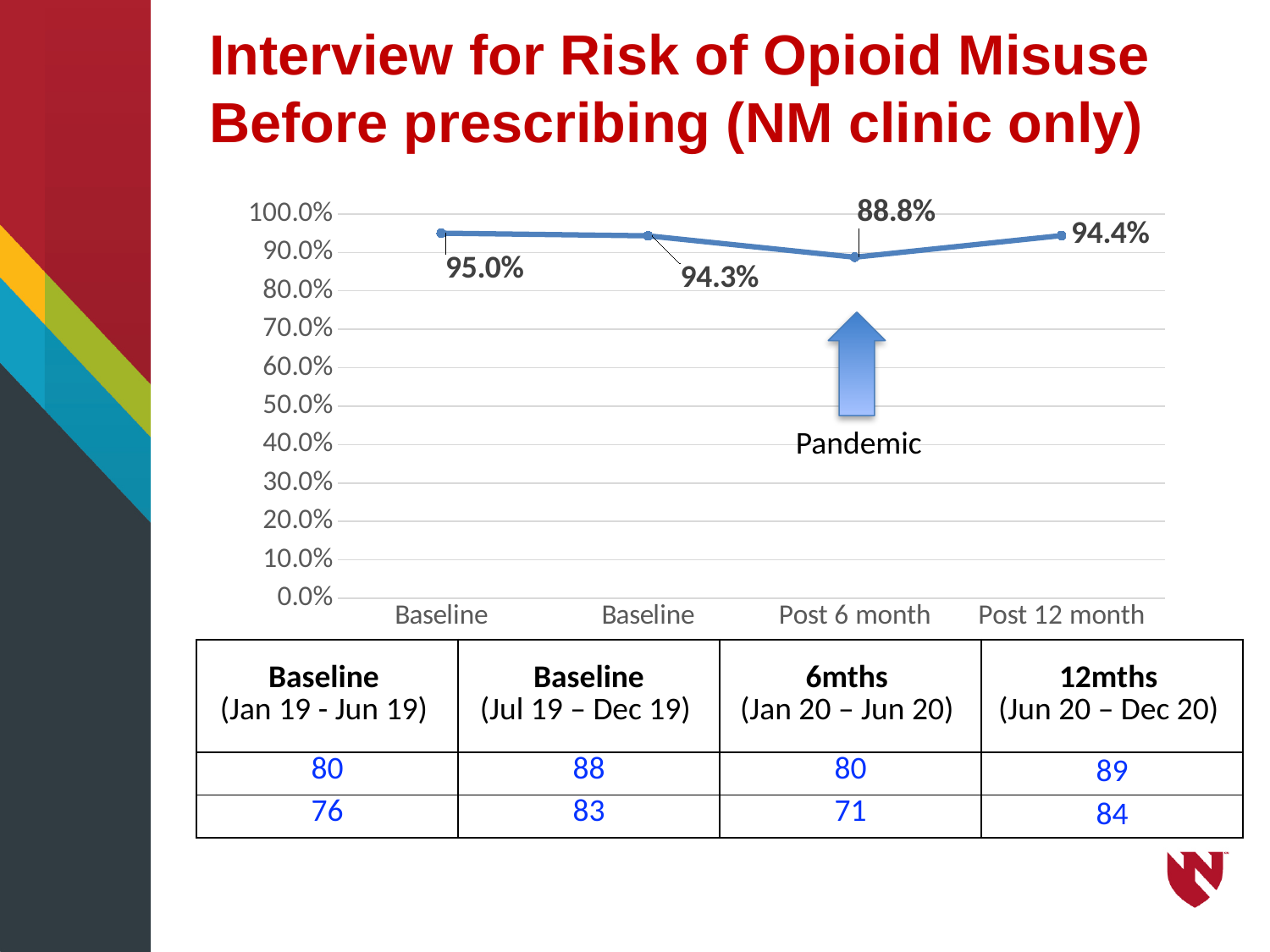
What is the difference between the Post 12 month value and the Post 6 month value? 5.6% Which is larger, the value for Post 6 month or the value for Post 12 month? Post 12 month What is the value for Post 6 month? 88.8% What type of chart is shown on the slide? line chart What is the value for Post 12 month? 94.4% How many data points are plotted on the line? 4 What event does the arrow annotation on the chart point to? Pandemic Is the value for Post 6 month greater or less than 90.0%? less What is the value for the second Baseline point? 94.3% Which category has the lowest value? Post 6 month Which category has the highest value? Baseline (the first, leftmost point) What is the value for the first Baseline point (leftmost)? 95.0%